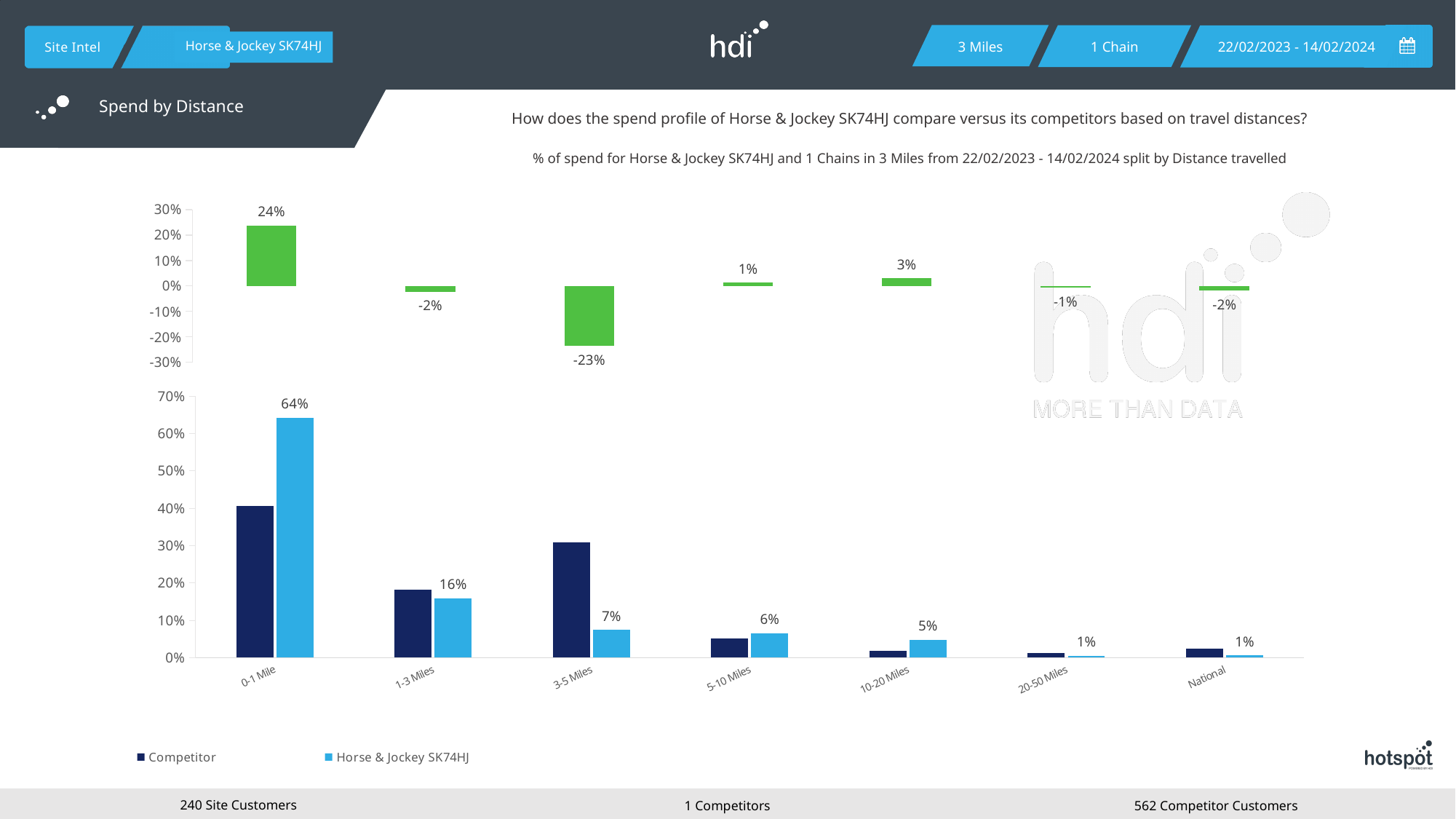
In the top chart, which category has the lowest value? 3-5 Miles In the bottom chart, what is the difference between the Horse & Jockey SK74HJ values for 0-1 Mile and 1-3 Miles? 48% In the bottom chart, what is the value for Horse & Jockey SK74HJ in the 0-1 Mile category? 64% In the top chart, which category has the highest value? 0-1 Mile In the top chart, what is the value for the 3-5 Miles category? -23% How many distance categories are shown on the x axis of the bottom chart? 7 In the bottom chart, do the Horse & Jockey SK74HJ values generally rise or fall from 0-1 Mile to National? Fall In the bottom chart, which is larger in the 3-5 Miles category: Competitor or Horse & Jockey SK74HJ? Competitor In the bottom chart, what is the value for Horse & Jockey SK74HJ in the 3-5 Miles category? 7% What kind of chart is the bottom chart? Bar chart In the bottom chart, is the Competitor value for 0-1 Mile greater or less than 30%? greater How many series does the legend of the bottom chart list? 2